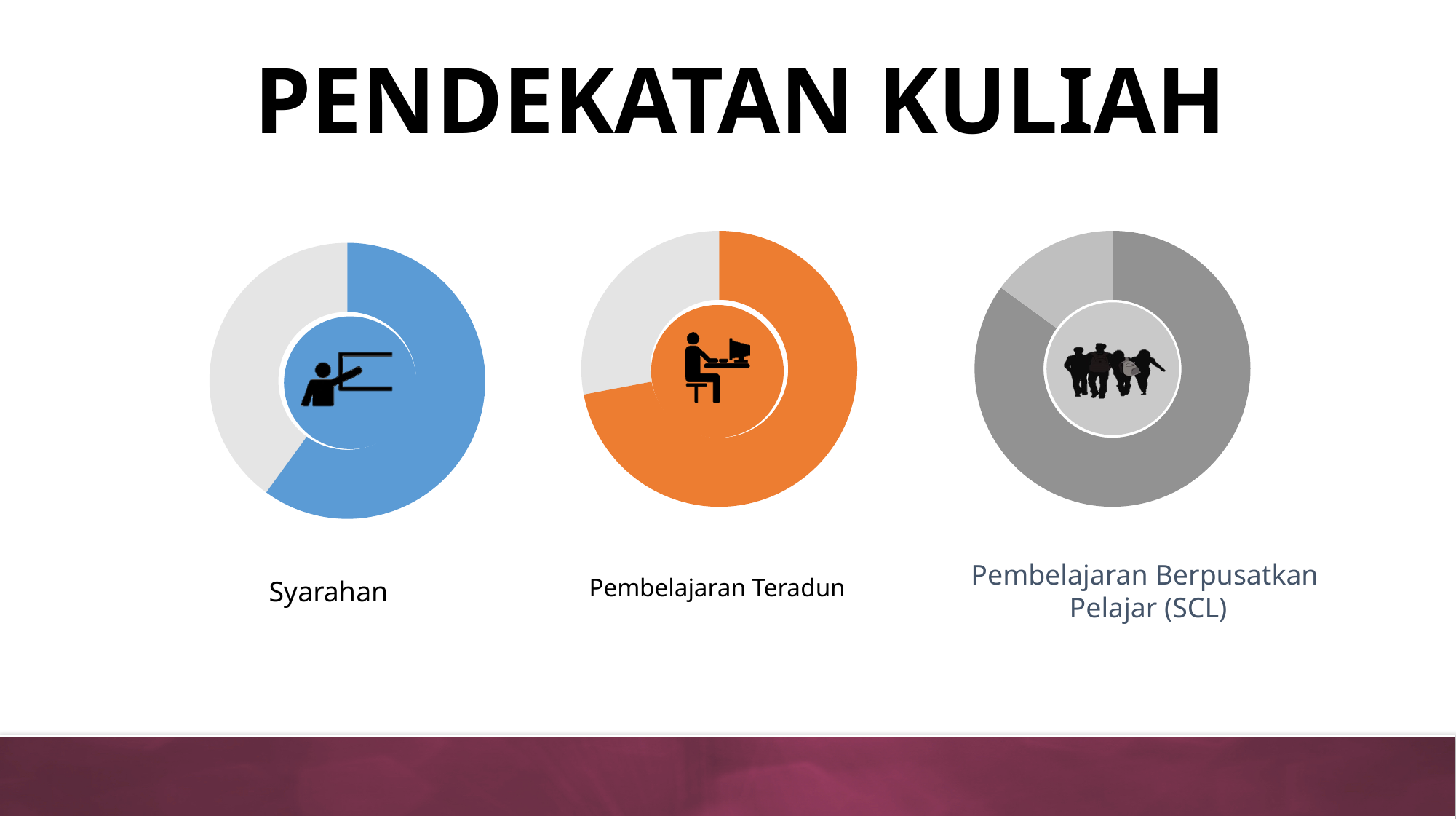
What kind of chart is shown under the label "Pembelajaran Teradun"? Doughnut chart What is the label under the leftmost chart? Syarahan In the "Pembelajaran Teradun" chart, which segment is larger, the orange segment or the light grey segment? Orange segment What colour is the main segment of the middle chart, labelled "Pembelajaran Teradun"? Orange In the "Pembelajaran Berpusatkan Pelajar (SCL)" chart, which segment is larger, the dark grey segment or the light grey segment? Dark grey segment In the "Syarahan" chart, which segment is larger, the blue segment or the light grey segment? Blue segment What kind of chart is shown under the label "Syarahan"? Doughnut chart How many doughnut charts are shown on the slide? 3